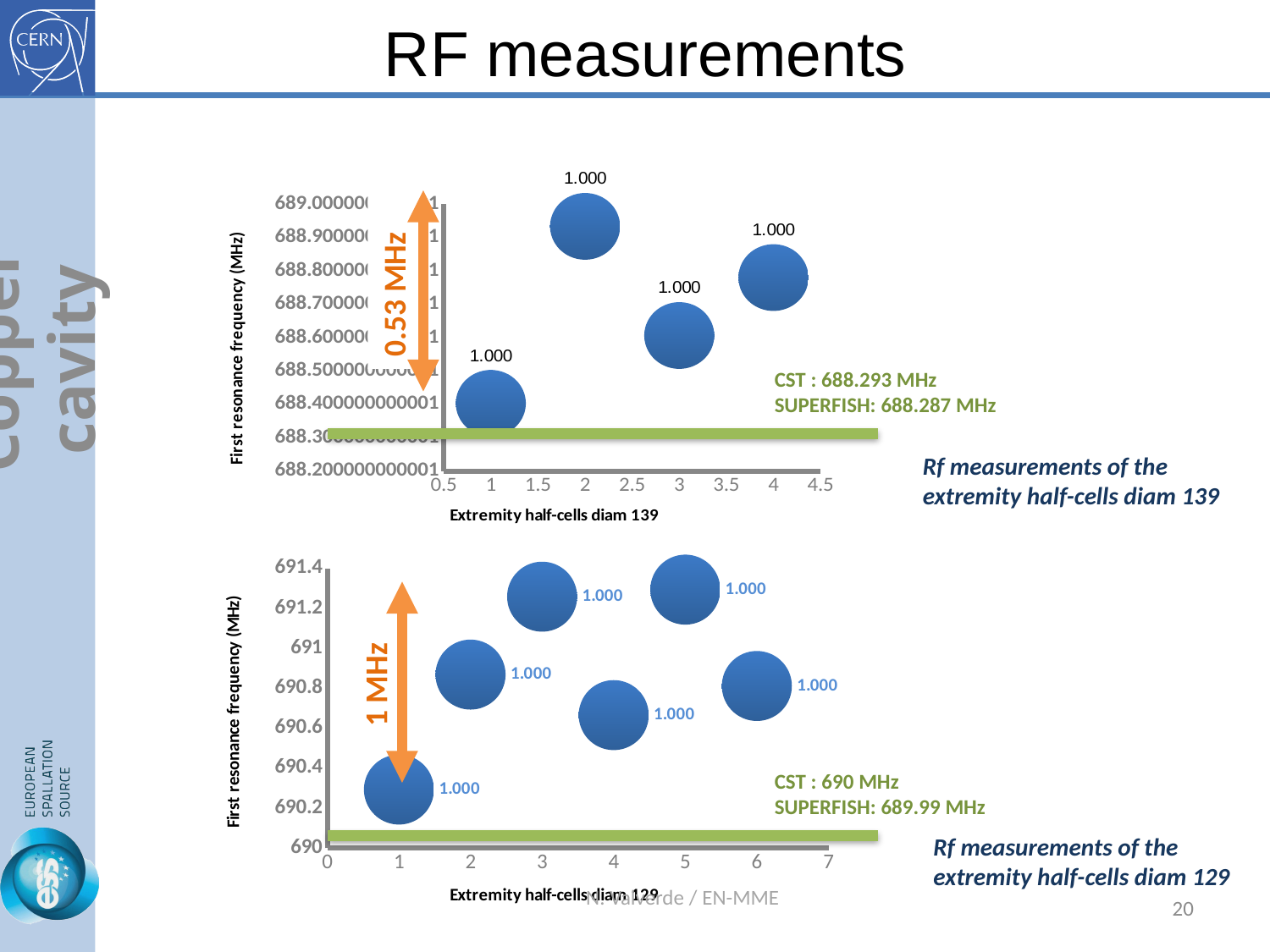
In the top chart (Extremity half-cells diam 139), how many data points are plotted? 4 In the bottom chart (Extremity half-cells diam 129), how many data points are plotted? 6 In the top chart (Extremity half-cells diam 139), at which x value is the lowest first resonance frequency plotted? 1 In the bottom chart (Extremity half-cells diam 129), is the frequency of the point at x = 1 greater or less than 690.4 MHz? less In the top chart (Extremity half-cells diam 139), is the frequency of the point at x = 4 greater or less than 688.7 MHz? greater What kind of chart is the top chart, 'Extremity half-cells diam 139'? bubble chart What is the y-axis title of the bottom chart (Extremity half-cells diam 129)? First resonance frequency (MHz) In the top chart (Extremity half-cells diam 139), is the frequency of the point at x = 1 greater or less than 688.5 MHz? less In the bottom chart (Extremity half-cells diam 129), which point has the higher frequency: the one at x = 2 or the one at x = 4? x = 2 In the bottom chart (Extremity half-cells diam 129), at which x value is the lowest first resonance frequency plotted? 1 In the top chart (Extremity half-cells diam 139), at which x value is the highest first resonance frequency plotted? 2